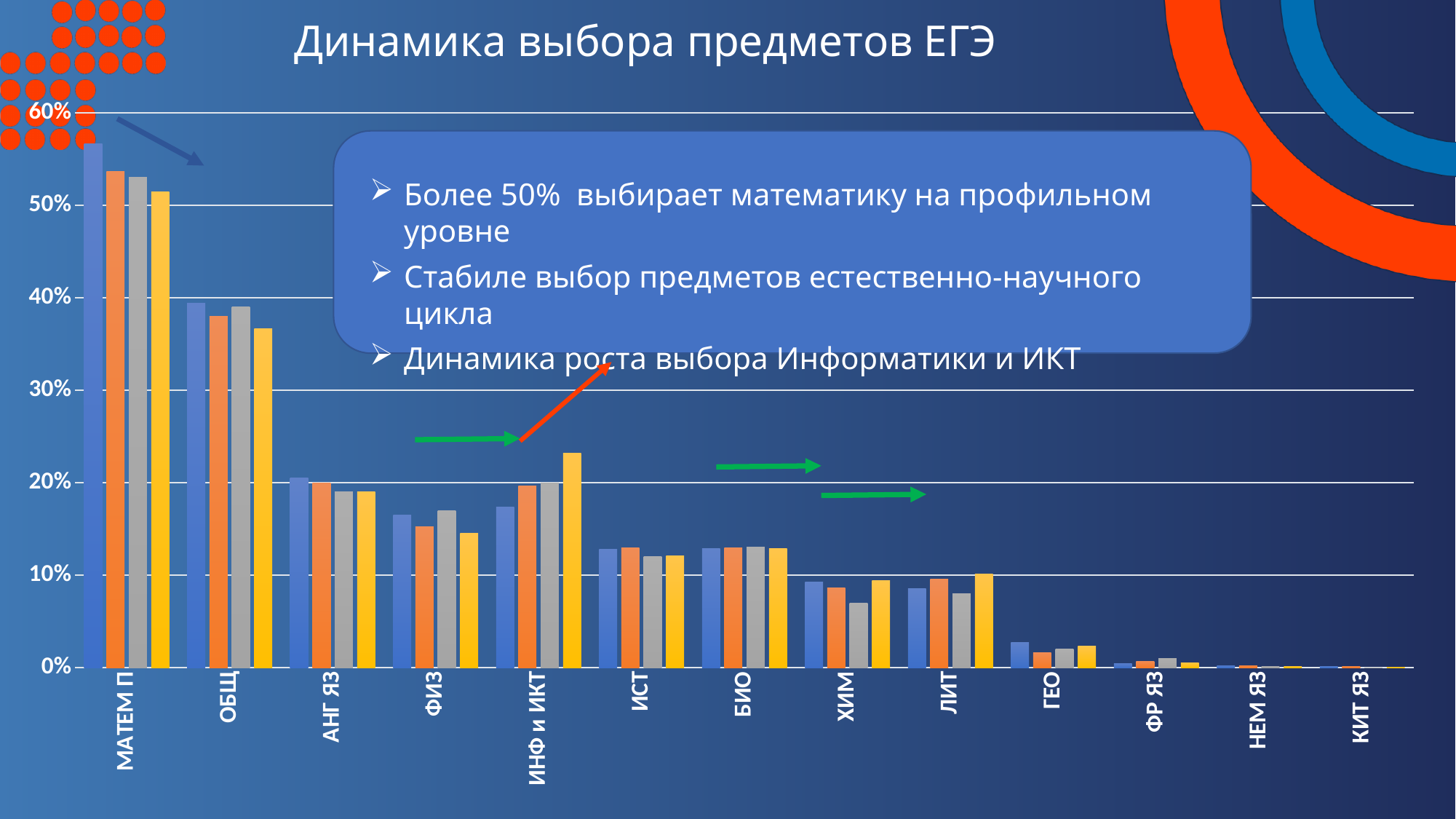
How many subject categories are shown on the x axis? 13 Is the value of the last (yellow) bar for ИНФ и ИКТ greater or less than 20%? greater Which subject has larger values, ОБЩ or АНГ ЯЗ? ОБЩ What kind of chart is shown on the slide? bar chart What is the title of the chart? Динамика выбора предметов ЕГЭ Do the values generally rise or fall moving from left to right along the x axis? fall Which subject has the lowest values in the chart? КИТ ЯЗ Are the values for ГЕО greater or less than 10%? less Which subject has the highest values in the chart? МАТЕМ П Is the value of the last (yellow) bar for ОБЩ greater or less than 40%? less How many bars are plotted for each subject category? 4